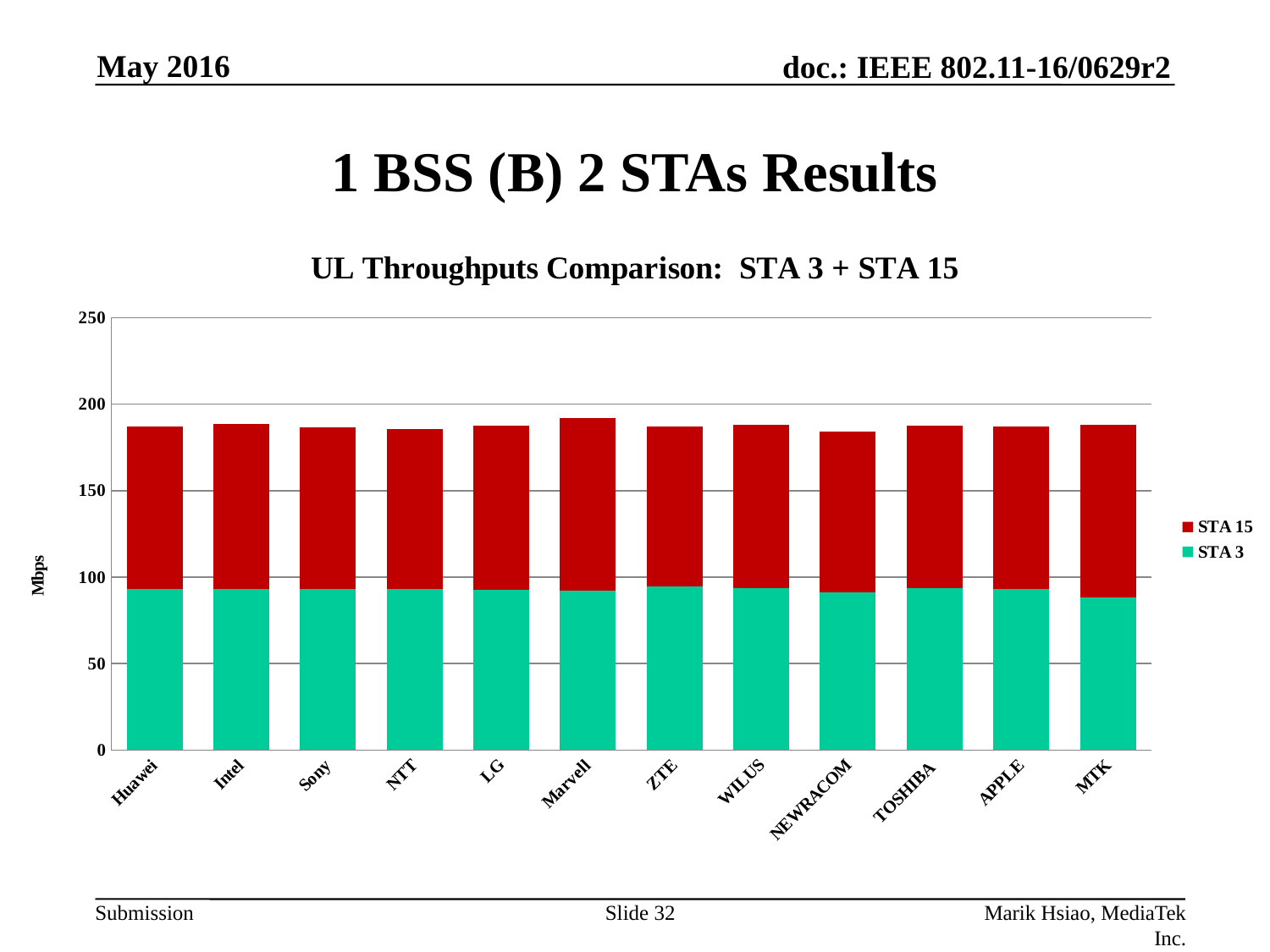
Is the total stacked bar for Huawei greater or less than 150? greater How many companies are shown along the x axis of the chart? 12 Is the total stacked bar for Marvell greater or less than 200? less What unit is shown on the chart's y axis label? Mbps Which company has the lowest STA 3 value? MTK Which company has the highest total stacked bar (STA 3 + STA 15)? Marvell How many series does the chart's legend list? 2 Is the STA 3 value for Huawei greater or less than 100? less What is the title of the chart? UL Throughputs Comparison: STA 3 + STA 15 Which is larger, the total stacked bar for Marvell or the total stacked bar for NEWRACOM? Marvell What kind of chart is shown on the slide? Stacked bar chart